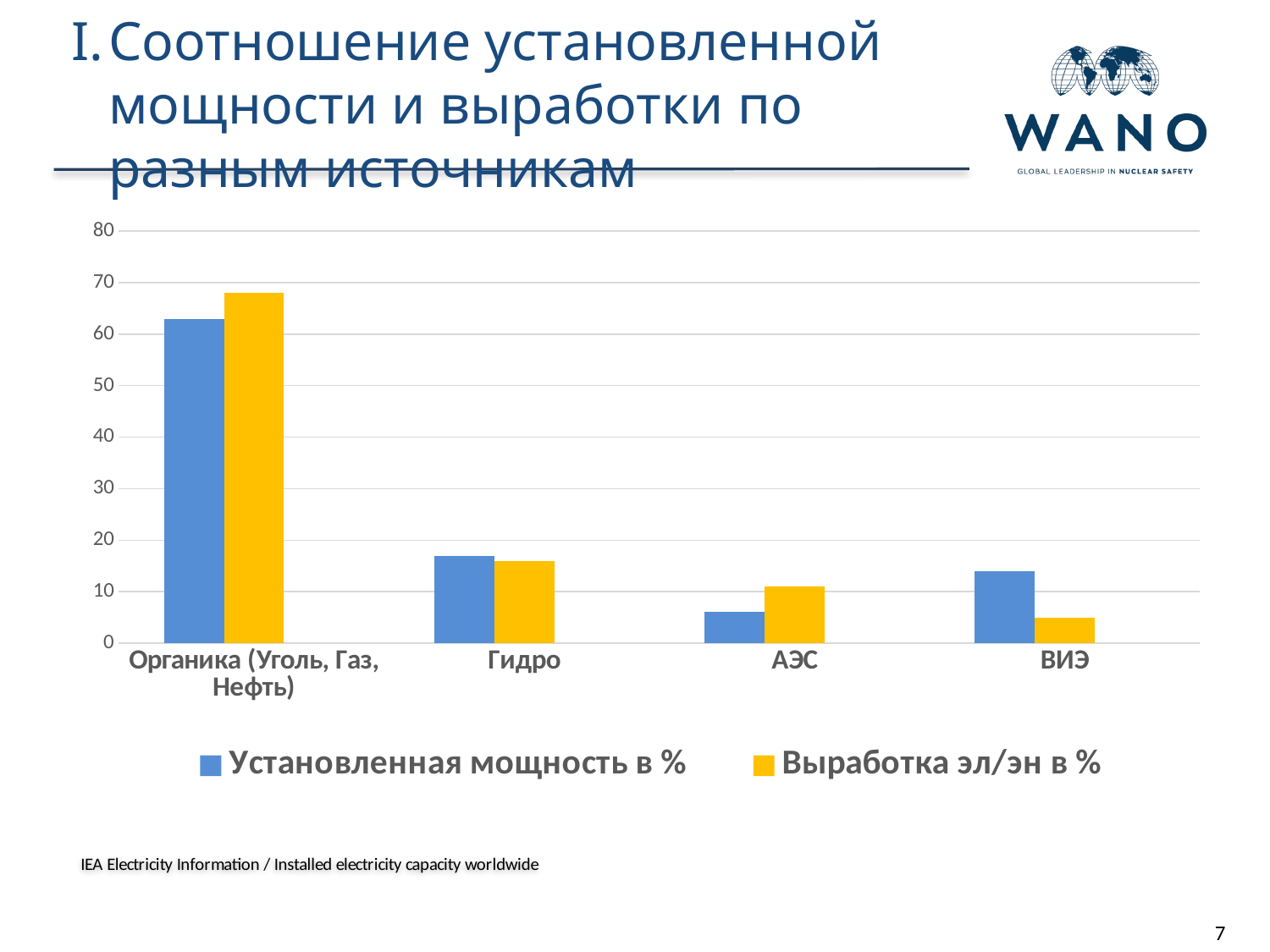
For АЭС, which is larger: Установленная мощность в % or Выработка эл/эн в %? Выработка эл/эн в % How many categories are shown on the x axis? 4 Which category has the highest value for Установленная мощность в %? Органика (Уголь, Газ, Нефть) How many series does the legend list? 2 Is the value of Установленная мощность в % for ВИЭ greater or less than 10? greater Which category has the lowest value for Выработка эл/эн в %? ВИЭ For ВИЭ, which is larger: Установленная мощность в % or Выработка эл/эн в %? Установленная мощность в % What kind of chart is shown on the slide? bar chart Which category has the lowest value for Установленная мощность в %? АЭС Which colour represents Выработка эл/эн в % in the legend? yellow Is the value of Выработка эл/эн в % for Органика (Уголь, Газ, Нефть) greater or less than 70? less Is the value of Установленная мощность в % for Органика (Уголь, Газ, Нефть) greater or less than 60? greater